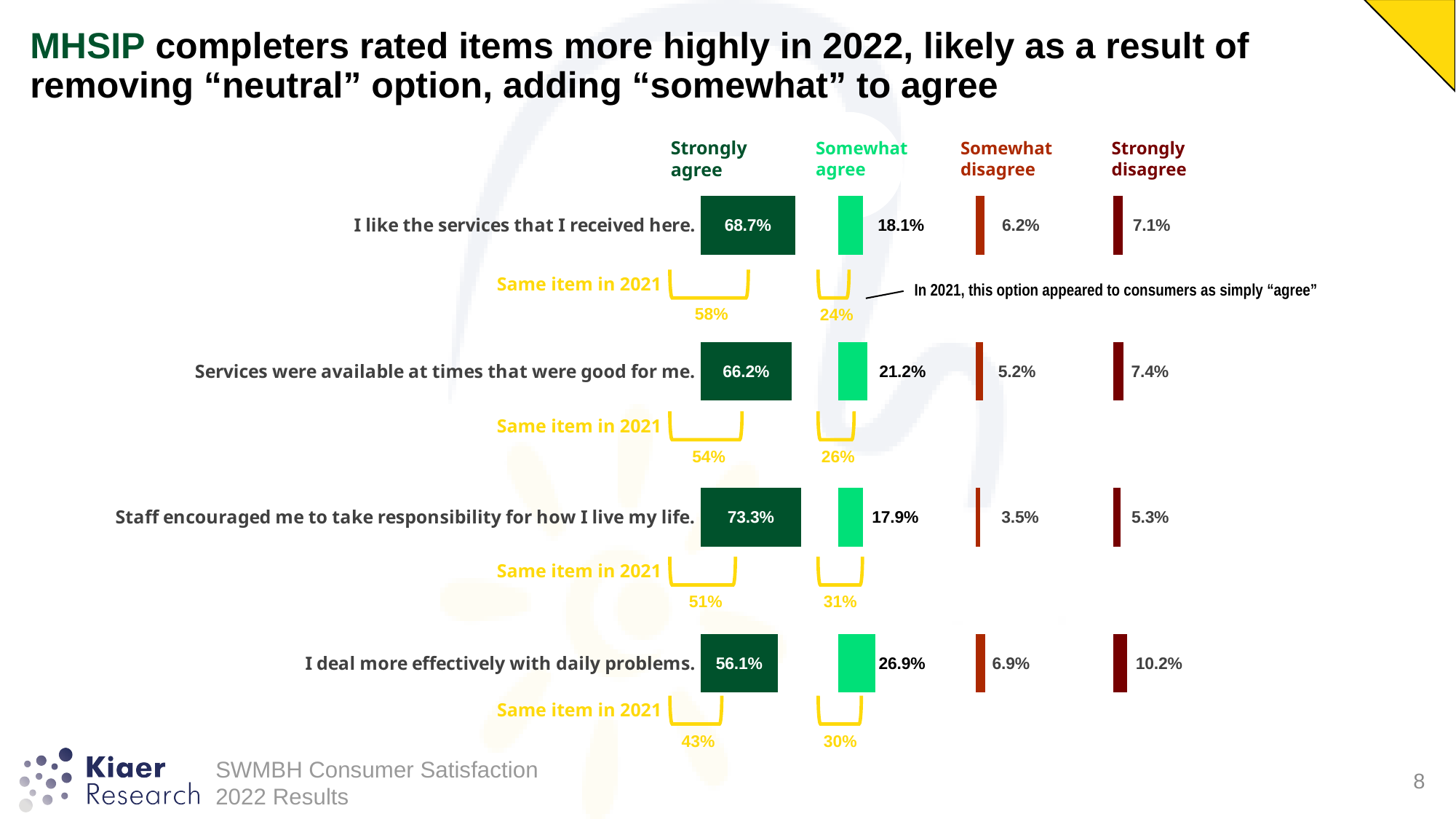
How many survey items are shown on the chart? 4 How many response categories are shown in the column headers of the chart? 4 What kind of chart is used on this slide? Bar chart What percentage of MHSIP completers strongly agreed with "I like the services that I received here." in 2022? 68.7% According to the annotation, how did the "Somewhat agree" option appear to consumers in 2021? Simply "agree" Which is larger: the "Strongly disagree" value for "Services were available at times that were good for me." or for "I like the services that I received here."? Services were available at times that were good for me. Which item has the highest "Strongly disagree" percentage? I deal more effectively with daily problems. Which item has the lowest "Somewhat disagree" percentage? Staff encouraged me to take responsibility for how I live my life. By how many percentage points did the "Strongly agree" value for "I like the services that I received here." change from 2021 (58%) to 2022 (68.7%)? 10.7 percentage points What is the "Somewhat agree" value for "I deal more effectively with daily problems."? 26.9% Which item has the highest "Strongly agree" percentage in 2022? Staff encouraged me to take responsibility for how I live my life. What was the "Strongly agree" value for "Staff encouraged me to take responsibility for how I live my life." in 2021? 51%